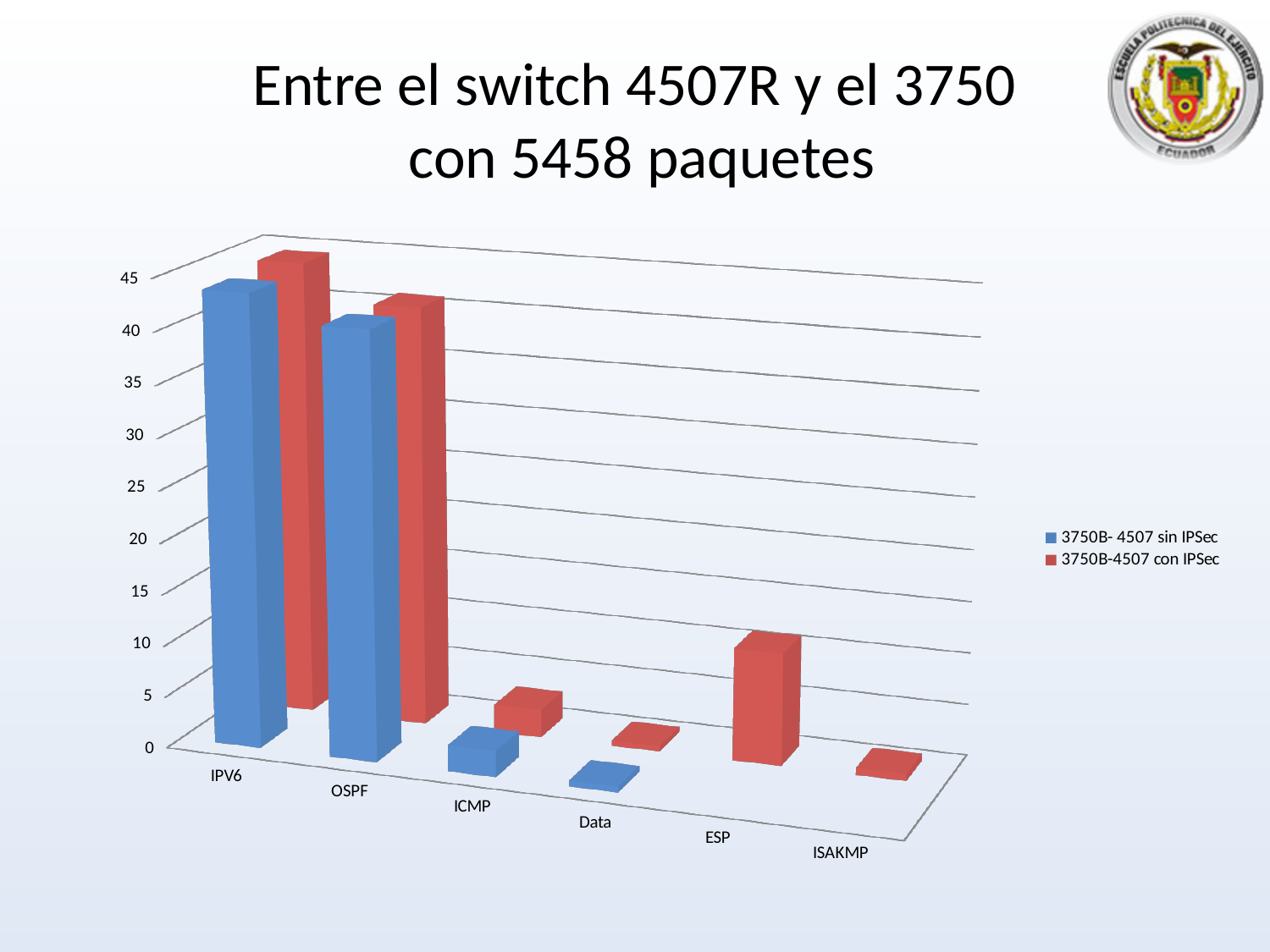
Is the value for IPV6 in the series 3750B- 4507 sin IPSec greater or less than 30? greater How many series does the chart's legend list? 2 What kind of chart is shown on the slide? bar chart What is the title of the slide containing the chart? Entre el switch 4507R y el 3750 con 5458 paquetes For the series 3750B- 4507 sin IPSec, which is larger: the value for OSPF or the value for ICMP? OSPF Is the value for ICMP in the series 3750B-4507 con IPSec greater or less than 15? less Is the value for OSPF in the series 3750B-4507 con IPSec greater or less than 25? greater Which category has the highest value for the series 3750B-4507 con IPSec? IPV6 For the series 3750B-4507 con IPSec, which is larger: the value for ESP or the value for ICMP? ESP How many categories are shown on the x axis of the chart? 6